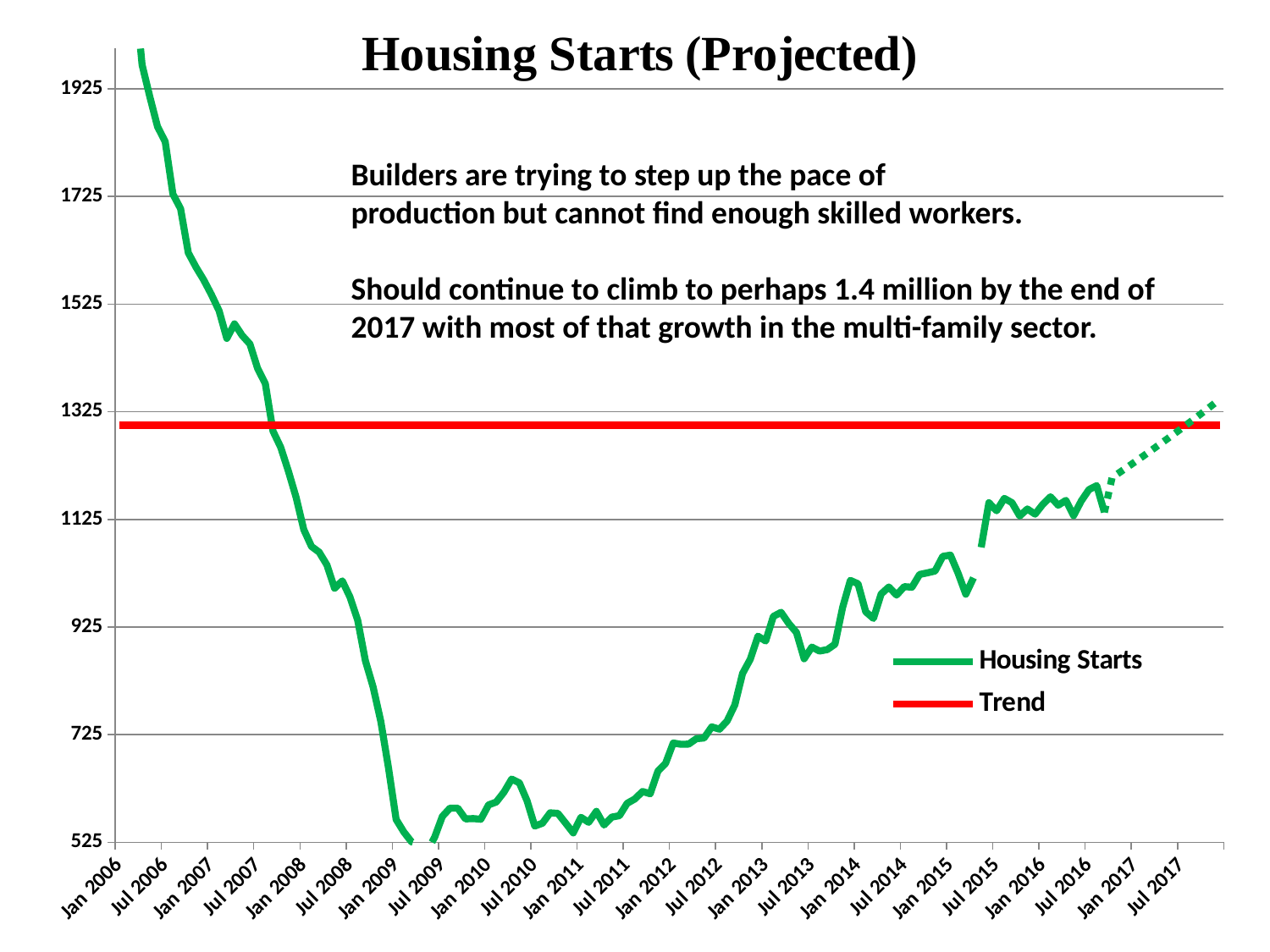
Is the Housing Starts value for Jan 2009 greater or less than 725? less Is the Housing Starts value for Jul 2007 greater or less than 1525? less Which is larger, the Housing Starts value for Jan 2007 or for Jan 2011? Jan 2007 What is the title of the chart? Housing Starts (Projected) How many series does the legend list? 2 Do Housing Starts rise or fall between Jan 2006 and Jan 2009? fall What kind of chart is shown on the slide? line chart What colour is the Trend line in the chart? red Do Housing Starts rise or fall between Jan 2011 and Jul 2017? rise Is the Housing Starts value for Jan 2008 greater or less than 1325? less